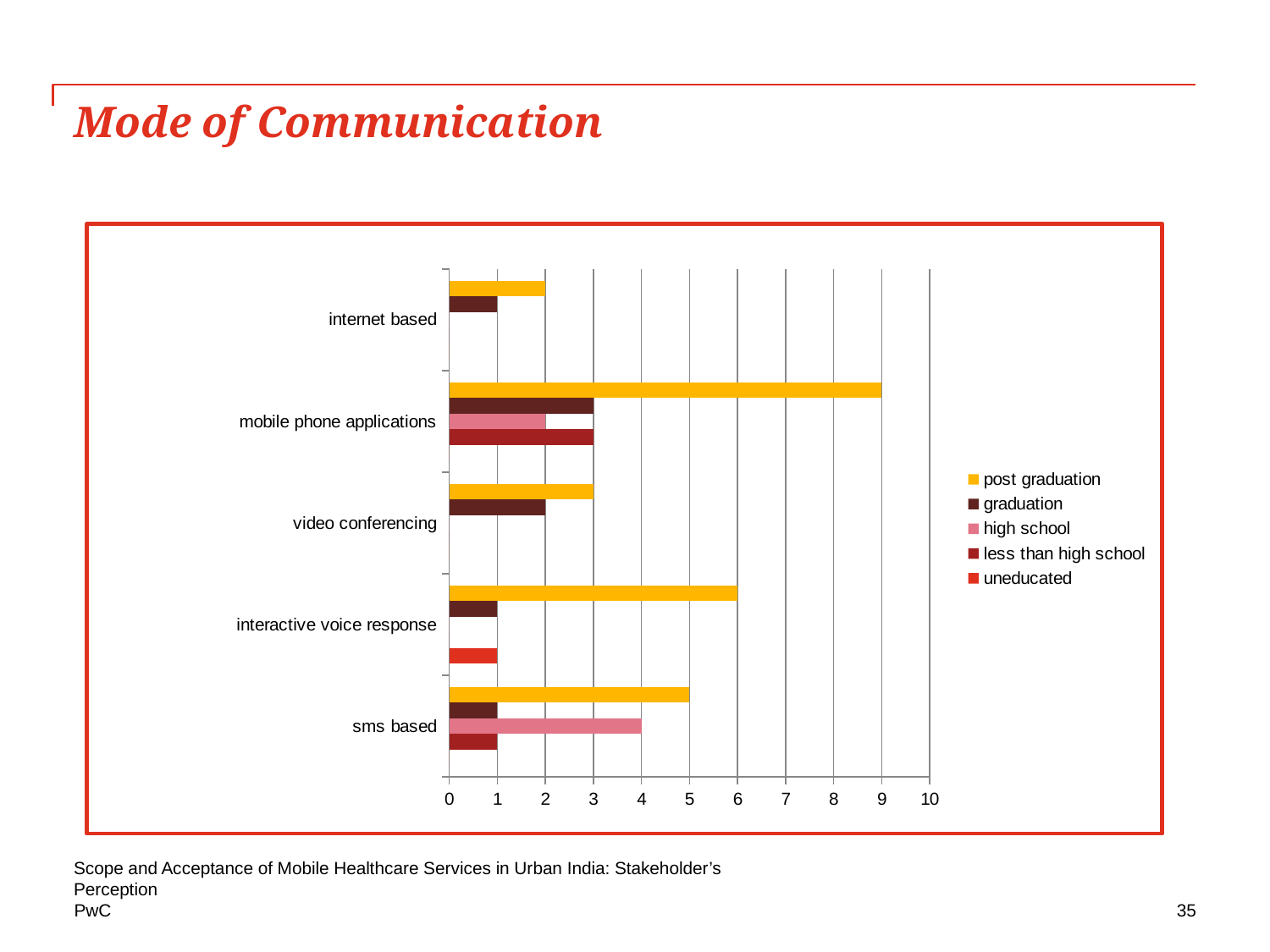
What kind of chart is shown on the slide? bar chart What is the post graduation value for mobile phone applications? 9 Which series is shown in yellow in the legend? post graduation Which mode of communication has the highest post graduation value? mobile phone applications What is the difference between the post graduation values for mobile phone applications and sms based? 4 How many series does the legend list? 5 How many modes of communication are shown on the y axis? 5 Which mode of communication has the lowest post graduation value? internet based Is the post graduation value for interactive voice response greater or less than 5? greater Which is larger, the graduation value for mobile phone applications or the graduation value for video conferencing? mobile phone applications What is the high school value for sms based? 4 What is the post graduation value for interactive voice response? 6